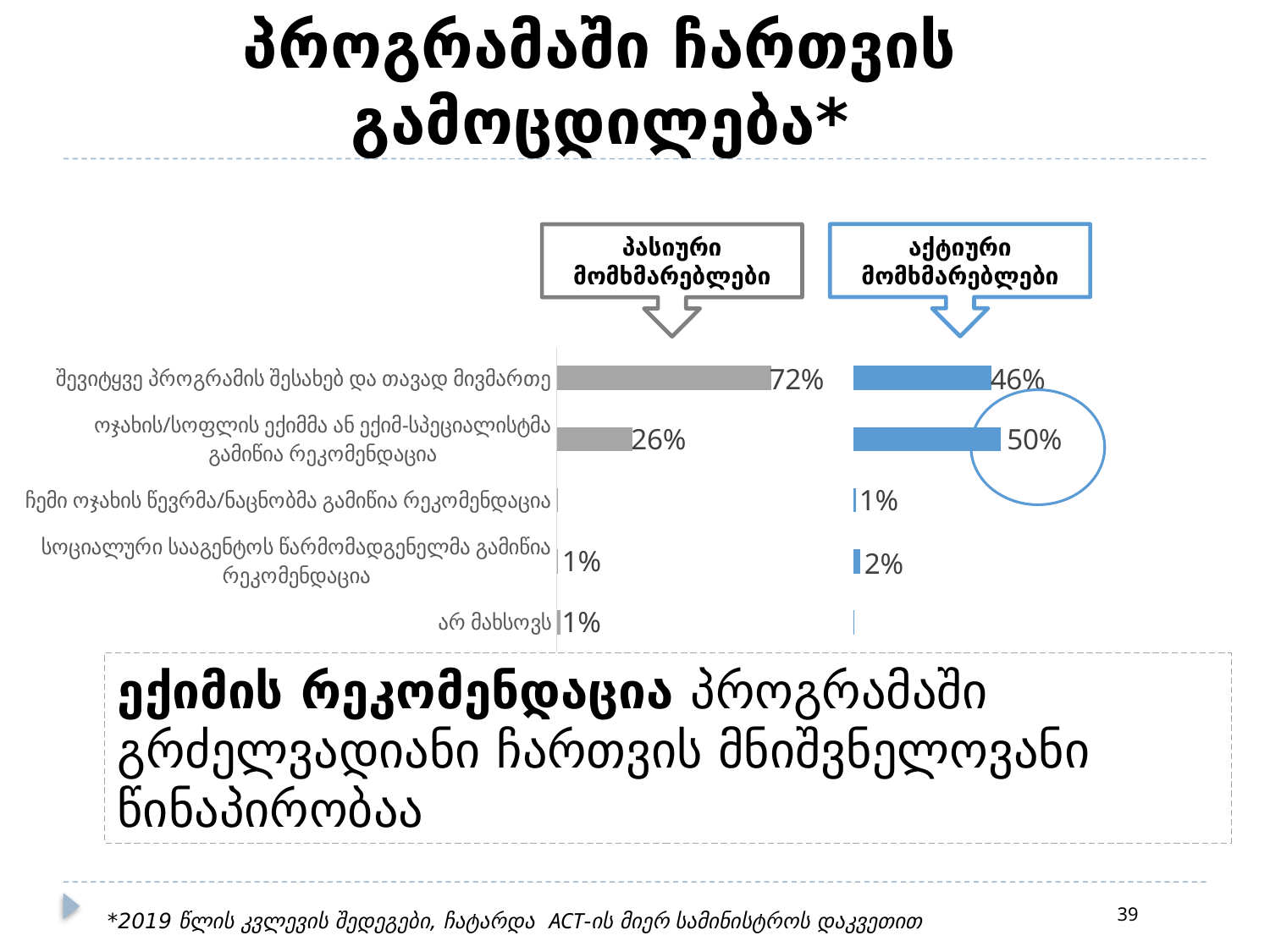
What type of chart is used on this slide? Bar chart In the passive users (პასიური მომხმარებლები) chart, what is the value for "ოჯახის/სოფლის ექიმმა ან ექიმ-სპეციალისტმა გამიწია რეკომენდაცია"? 26% For "შევიტყვე პროგრამის შესახებ და თავად მივმართე", which chart shows the larger value: passive users or active users? Passive users (პასიური მომხმარებლები) How many categories are listed on the y axis of the charts? 5 In the active users (აქტიური მომხმარებლები) chart, what is the value for "სოციალური სააგენტოს წარმომადგენელმა გამიწია რეკომენდაცია"? 2% In the active users (აქტიური მომხმარებლები) chart, what is the value for "შევიტყვე პროგრამის შესახებ და თავად მივმართე"? 46% In the passive users (პასიური მომხმარებლები) chart, what is the value for "შევიტყვე პროგრამის შესახებ და თავად მივმართე"? 72% What is the difference between the active users' and passive users' values for "ოჯახის/სოფლის ექიმმა ან ექიმ-სპეციალისტმა გამიწია რეკომენდაცია"? 24% In the passive users (პასიური მომხმარებლები) chart, what is the difference between "შევიტყვე პროგრამის შესახებ და თავად მივმართე" and "ოჯახის/სოფლის ექიმმა ან ექიმ-სპეციალისტმა გამიწია რეკომენდაცია"? 46% In the active users (აქტიური მომხმარებლები) chart, what is the value for "ოჯახის/სოფლის ექიმმა ან ექიმ-სპეციალისტმა გამიწია რეკომენდაცია"? 50% In the active users (აქტიური მომხმარებლები) chart, which category has the highest value? ოჯახის/სოფლის ექიმმა ან ექიმ-სპეციალისტმა გამიწია რეკომენდაცია In the passive users (პასიური მომხმარებლები) chart, which category has the highest value? შევიტყვე პროგრამის შესახებ და თავად მივმართე